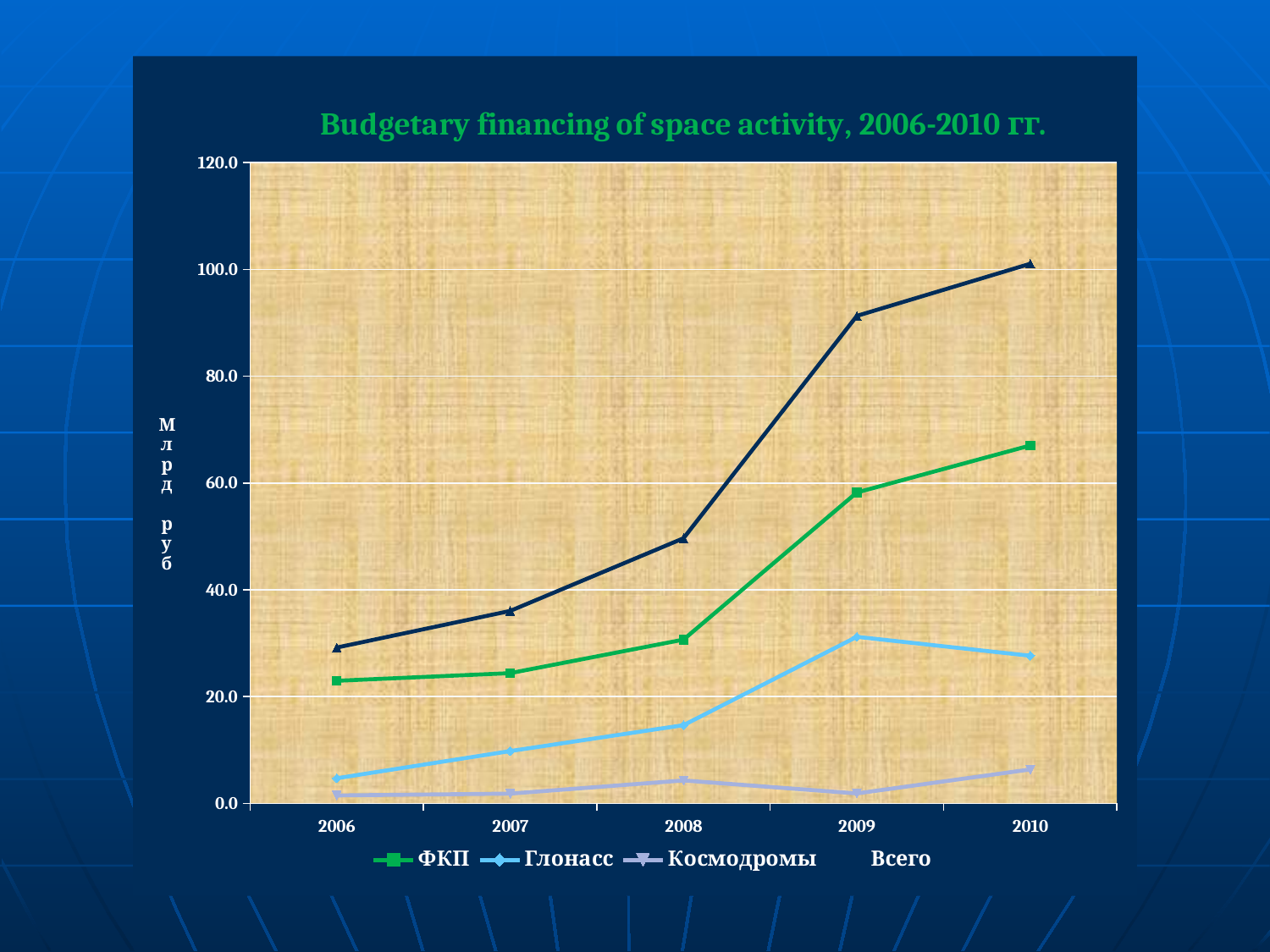
Is the value for ФКП in 2010 greater or less than 60.0? greater Is the value for Глонасс in 2009 greater or less than 20.0? greater How many series does the legend list? 4 Does the Всего series rise or fall from 2006 to 2010? rise Which series is drawn in green? ФКП What kind of chart is shown on the slide? line chart What is the title of the chart? Budgetary financing of space activity, 2006-2010 гг. Is the value for Всего in 2009 greater or less than 80.0? greater In which year does the Всего series reach its highest value? 2010 How many years are plotted along the x axis? 5 In which year does the Глонасс series reach its highest value? 2009